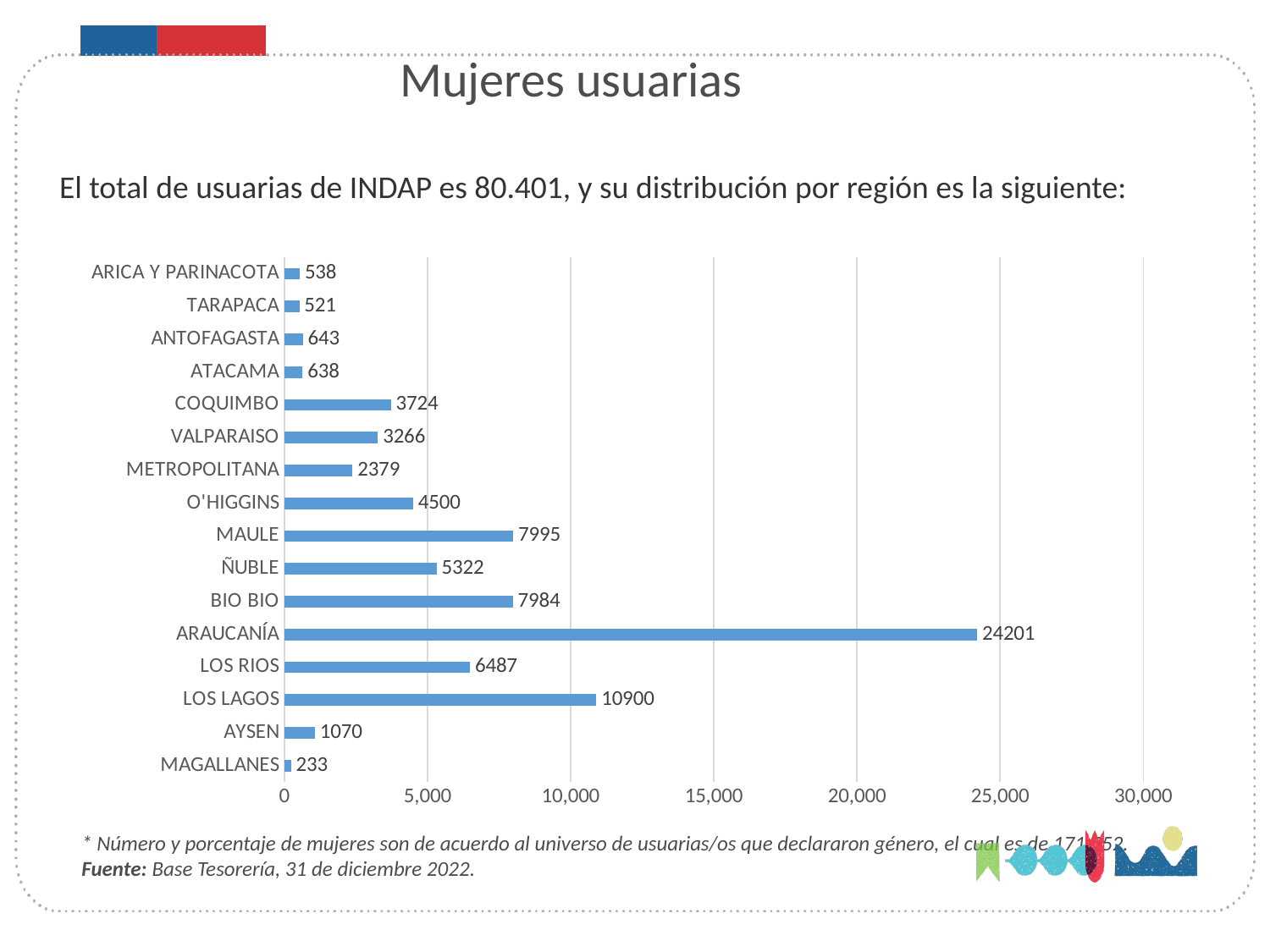
Which region has the highest value? ARAUCANÍA What is the value for METROPOLITANA? 2379 What is the value for LOS LAGOS? 10900 Which has a larger value, COQUIMBO or VALPARAISO? COQUIMBO What is the value for ÑUBLE? 5322 Which region has the lowest value? MAGALLANES What is the difference between the values for LOS LAGOS and LOS RIOS? 4413 How many regions are shown in the chart? 16 What kind of chart is shown on the slide? bar chart What is the title of the slide? Mujeres usuarias Is the value for ARAUCANÍA greater or less than 20,000? greater What is the value for ARAUCANÍA? 24201